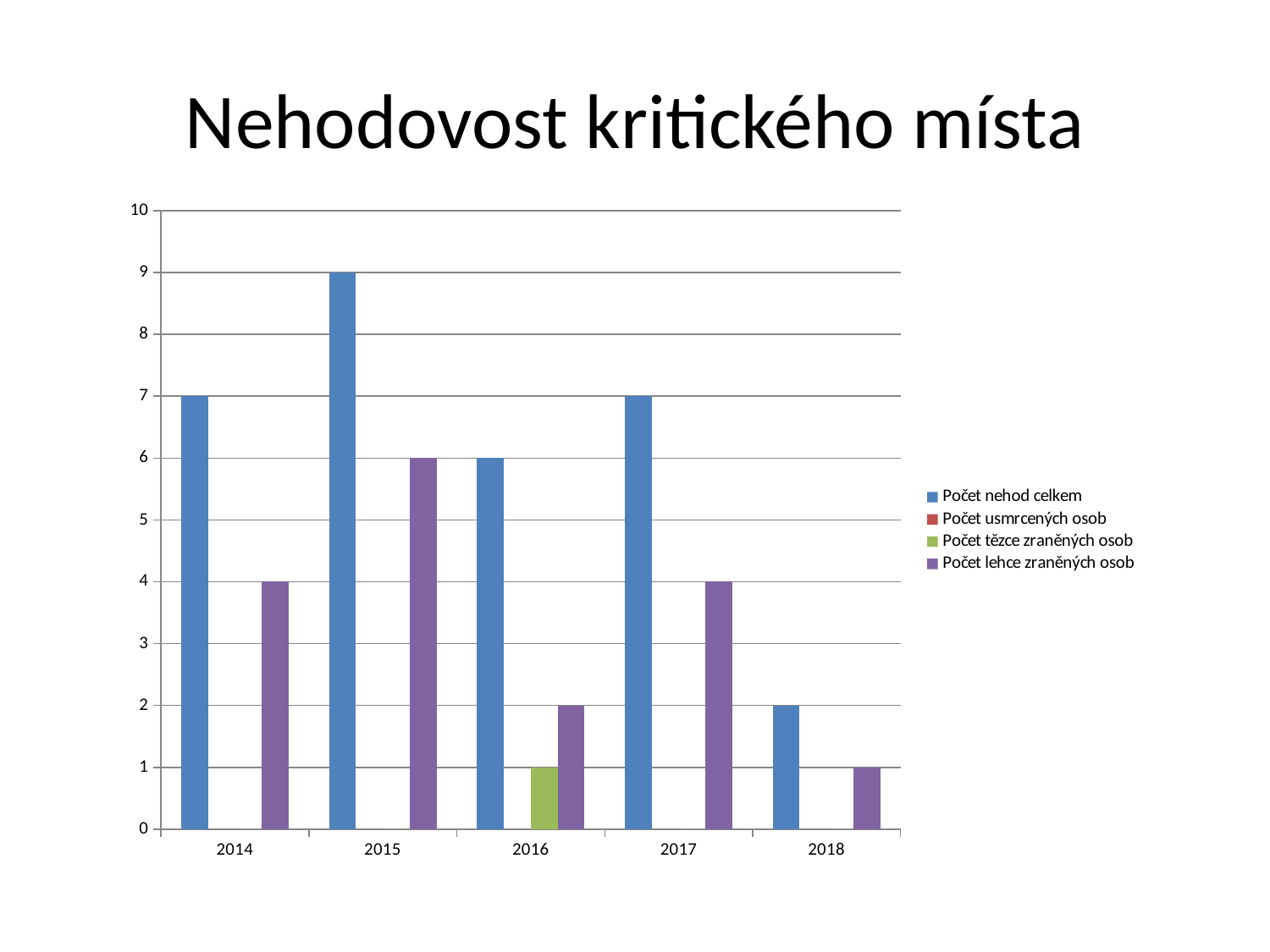
In which year is Počet nehod celkem lowest? 2018 What is the title of the chart? Nehodovost kritického místa What is the value of Počet nehod celkem for 2015? 9 Does Počet nehod celkem rise or fall from 2017 to 2018? fall How many series does the legend list? 4 What is the value of Počet lehce zraněných osob for 2014? 4 How many years are shown on the x axis? 5 Which is larger in 2017: Počet nehod celkem or Počet lehce zraněných osob? Počet nehod celkem What kind of chart is shown on the slide? bar chart What is the difference between Počet nehod celkem in 2015 and in 2018? 7 What is the value of Počet těžce zraněných osob for 2016? 1 In which year is Počet nehod celkem highest? 2015